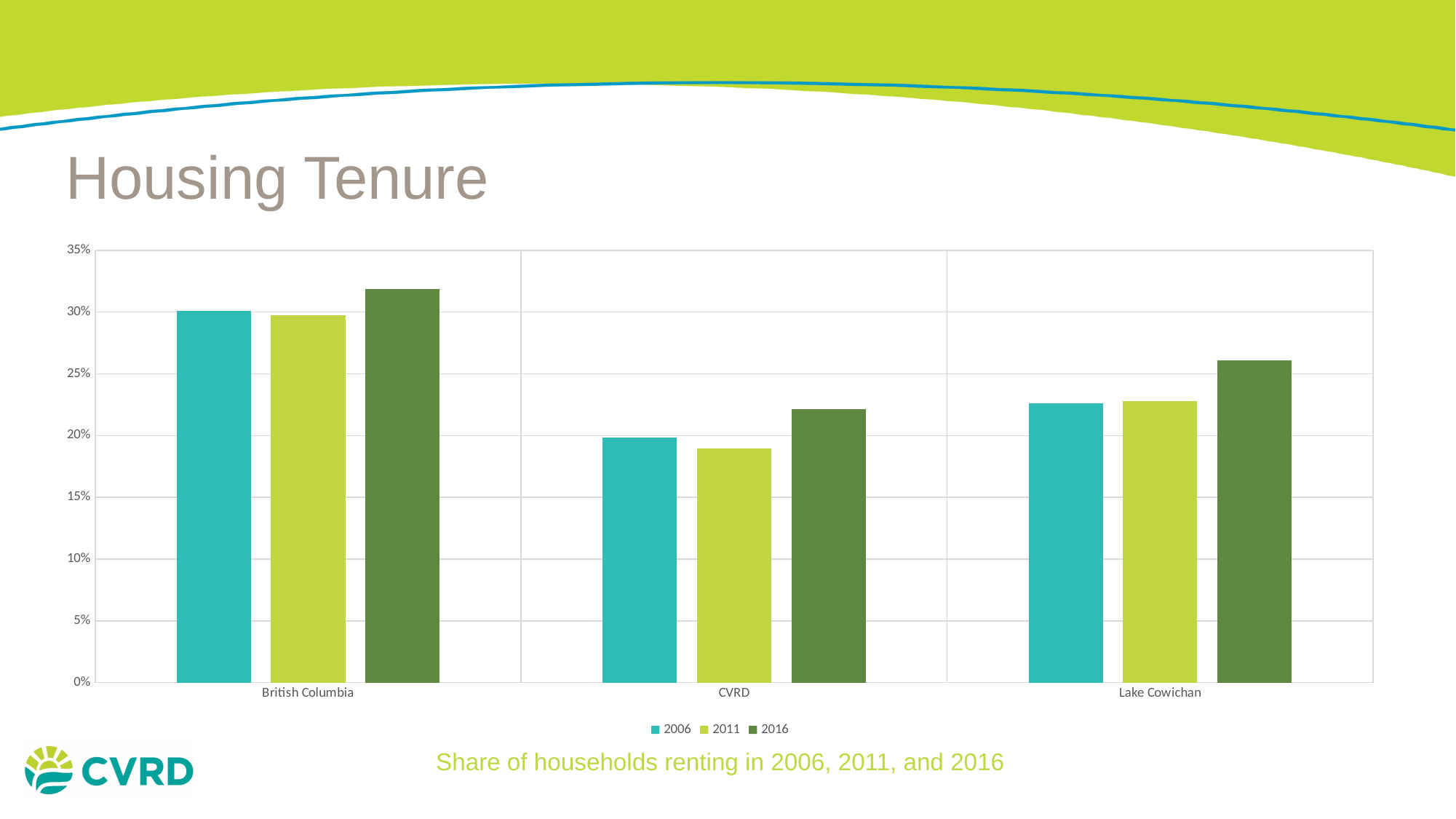
Is the value for CVRD in 2011 greater or less than 20%? less What are the three years listed in the legend? 2006, 2011, 2016 Is the value for Lake Cowichan in 2016 greater or less than 25%? greater What kind of chart is shown on the slide? bar chart How many series does the legend list? 3 Which category has the lowest value for 2011? CVRD Which is larger, the 2016 value for CVRD or the 2016 value for Lake Cowichan? Lake Cowichan For British Columbia, which year has the highest value? 2016 Is the value for British Columbia in 2016 greater or less than 30%? greater Which category has the highest value for 2016? British Columbia How many categories are shown on the x axis? 3 Which is larger, the 2006 value for British Columbia or the 2006 value for CVRD? British Columbia